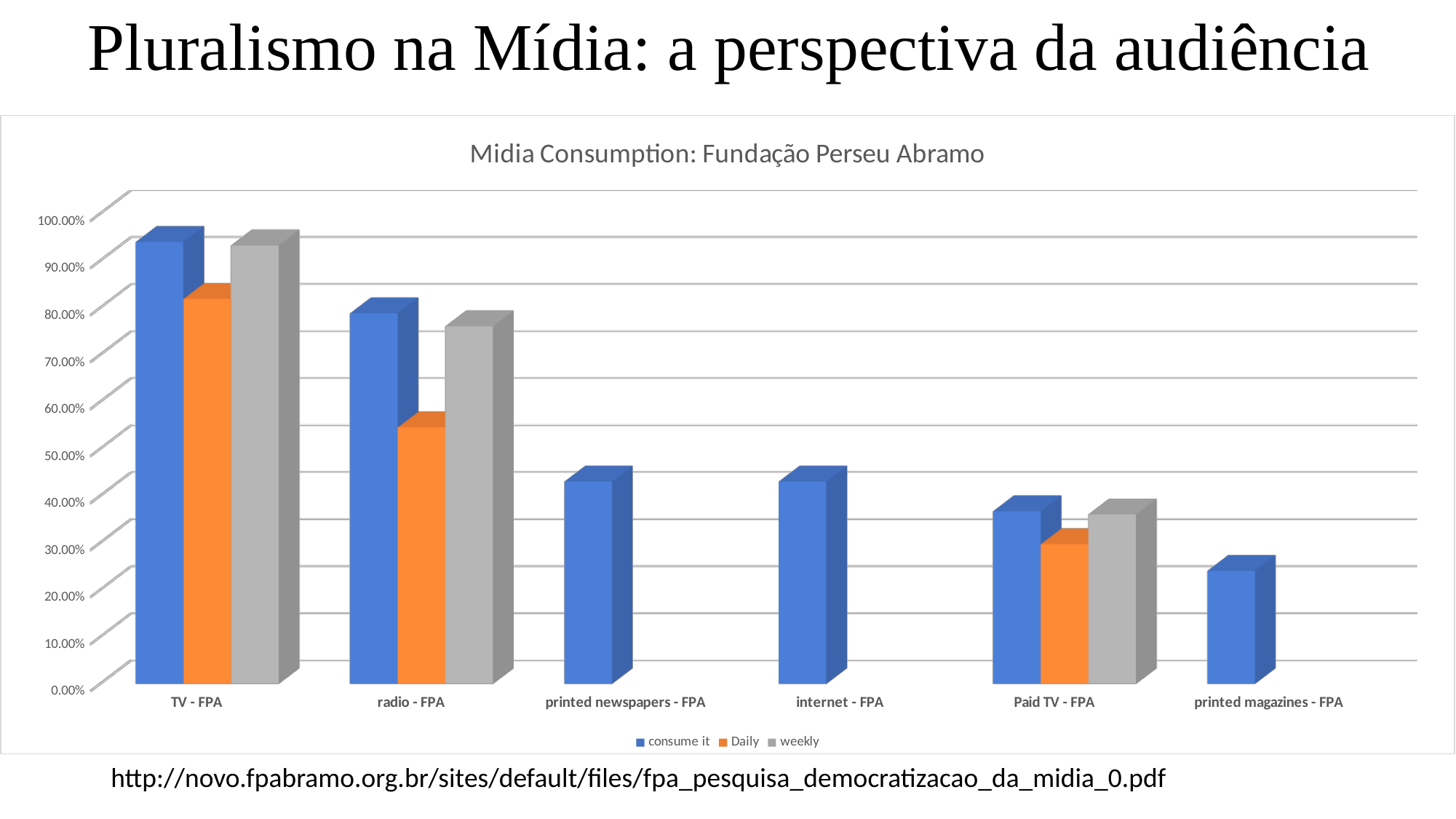
Which is larger, the 'Daily' value for TV - FPA or the 'Daily' value for radio - FPA? TV - FPA Which category has the lowest 'consume it' value? printed magazines - FPA Which colour represents the 'Daily' series in the chart? orange Which category has the highest 'consume it' value? TV - FPA Is the 'Daily' value for radio - FPA greater or less than 70.00%? less What kind of chart is shown on the slide? bar chart Is the 'consume it' value for TV - FPA greater or less than 80.00%? greater What is the title of the chart? Midia Consumption: Fundação Perseu Abramo Is the 'consume it' value for printed newspapers - FPA greater or less than 30.00%? greater How many categories are shown on the x axis of the chart? 6 How many series does the chart's legend list? 3